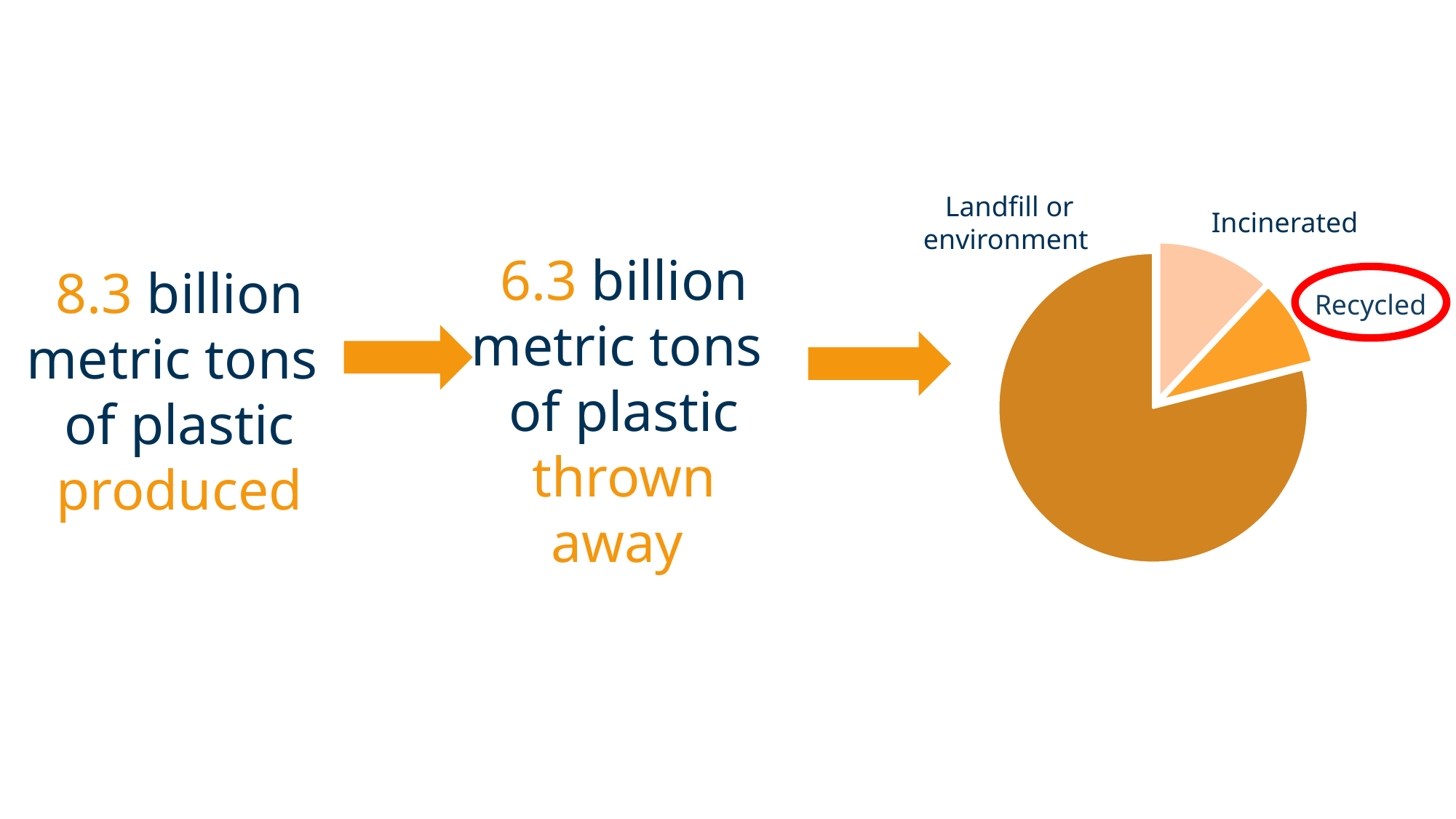
What kind of chart is shown on the right of the slide? pie chart What are the three categories shown in the pie chart? Landfill or environment, Incinerated, Recycled In the pie chart, which slice is larger: Incinerated or Recycled? Incinerated Which category has the largest slice in the pie chart? Landfill or environment How many slices does the pie chart have? 3 In the pie chart, which slice is larger: Landfill or environment, or Incinerated? Landfill or environment Which slice label in the pie chart is circled in red? Recycled Which category has the smallest slice in the pie chart? Recycled